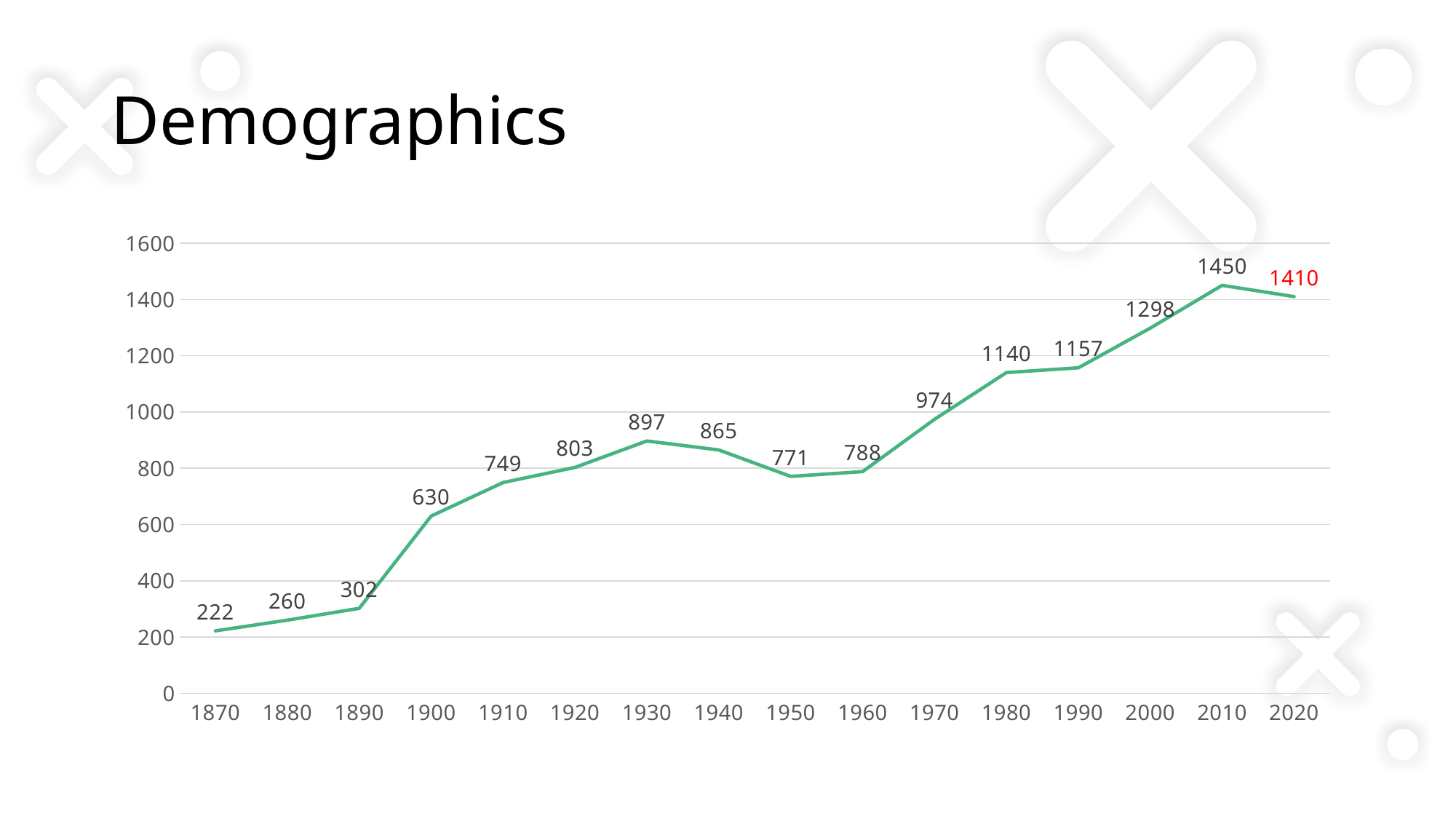
What is the difference between the values for 1930 and 1870? 675 What is the value for 1900? 630 What is the value for 2020? 1410 Is the value for 1980 greater or less than 1000? greater What kind of chart is shown on the slide? line chart How many years are plotted on the x axis? 16 Which year has the lowest value? 1870 What is the difference between the values for 2010 and 2020? 40 What is the value for 1950? 771 Which is larger, the value for 1940 or the value for 1960? 1940 What is the title of the slide? Demographics Which year has the highest value? 2010